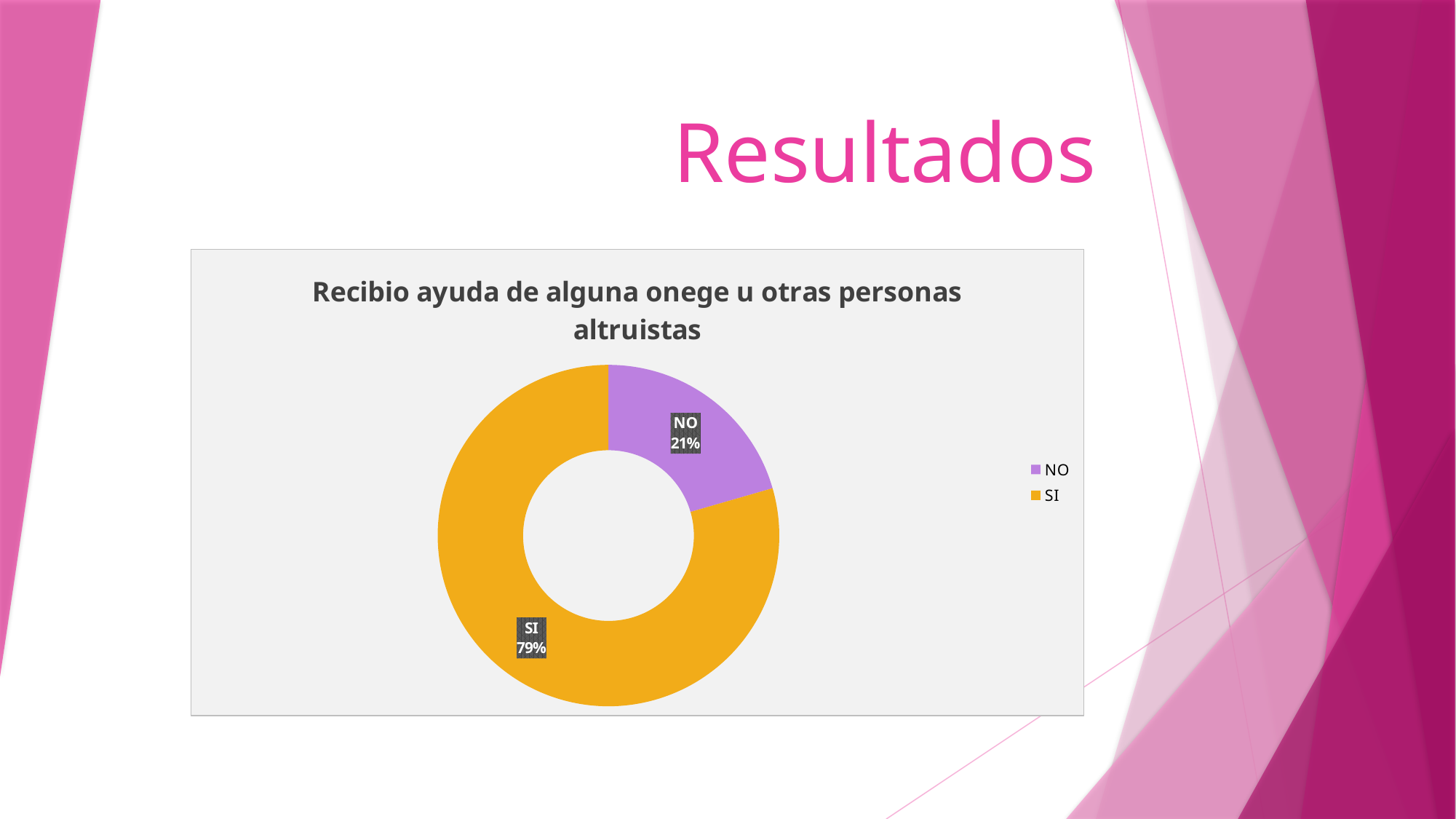
What share of the doughnut chart does the SI slice represent? 79% Which slice is larger, SI or NO? SI Which category has the smallest slice in the chart? NO What is the difference in percentage points between the SI and NO slices? 58 What share of the doughnut chart does the NO slice represent? 21% How many categories are shown in the chart? 2 What kind of chart is shown on the slide? Doughnut chart What is the title of the chart? Recibio ayuda de alguna onege u otras personas altruistas How many entries does the chart legend list? 2 What colour is the SI slice in the chart? Orange Which category has the largest slice in the chart? SI